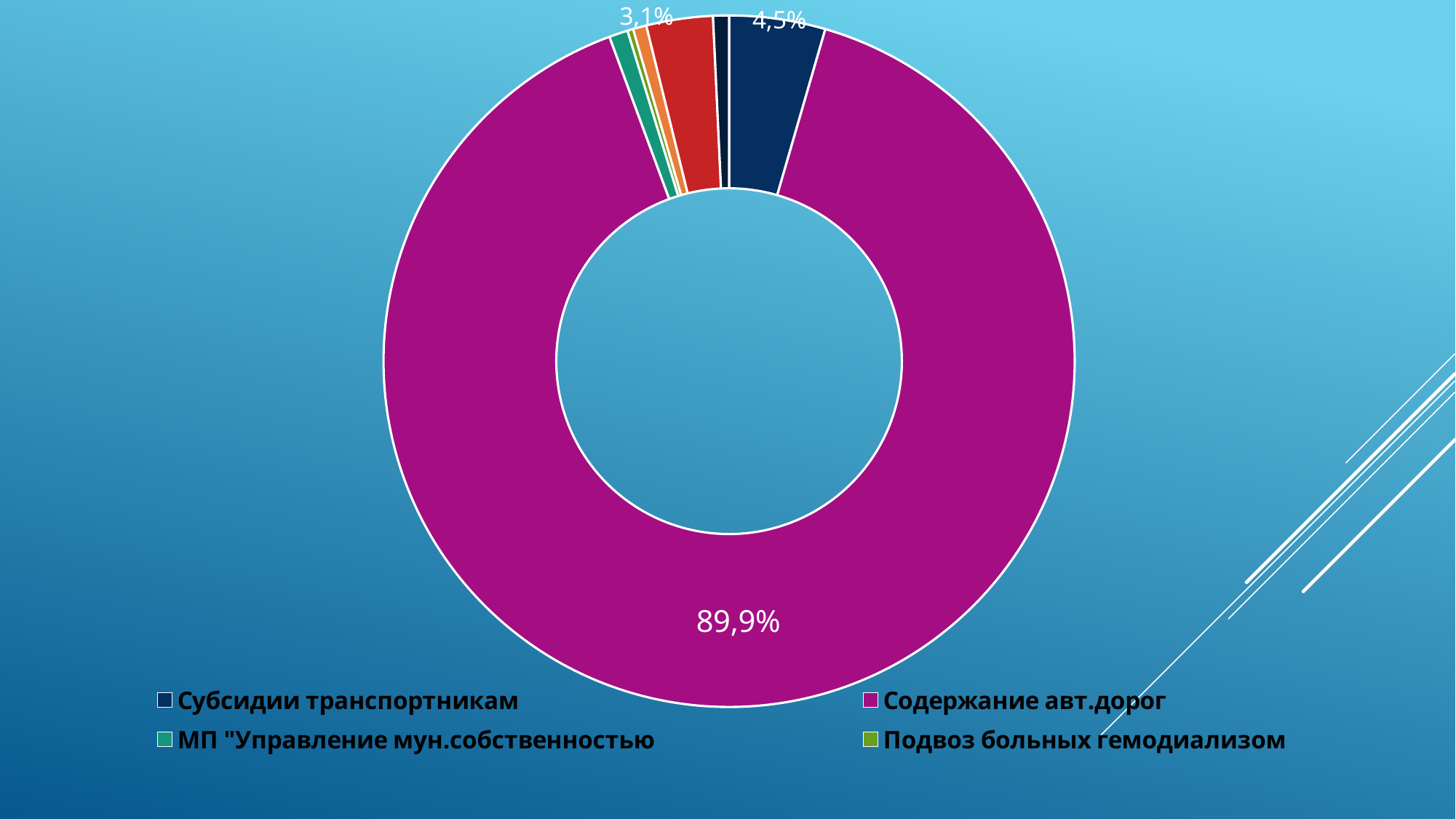
What percentage is shown for Субсидии транспортникам? 4,5% What percentage is shown for Содержание авт.дорог? 89,9% Which category has the largest share of the doughnut chart? Содержание авт.дорог Which is larger: the share for Содержание авт.дорог or the share for Субсидии транспортникам? Содержание авт.дорог What colour is the slice for Содержание авт.дорог? Magenta What colour is the slice for Субсидии транспортникам? Dark blue What kind of chart is shown on the slide? Pie (doughnut) chart How many entries does the legend list? 4 What is the difference in percentage points between Содержание авт.дорог (89,9%) and Субсидии транспортникам (4,5%)? 85,4